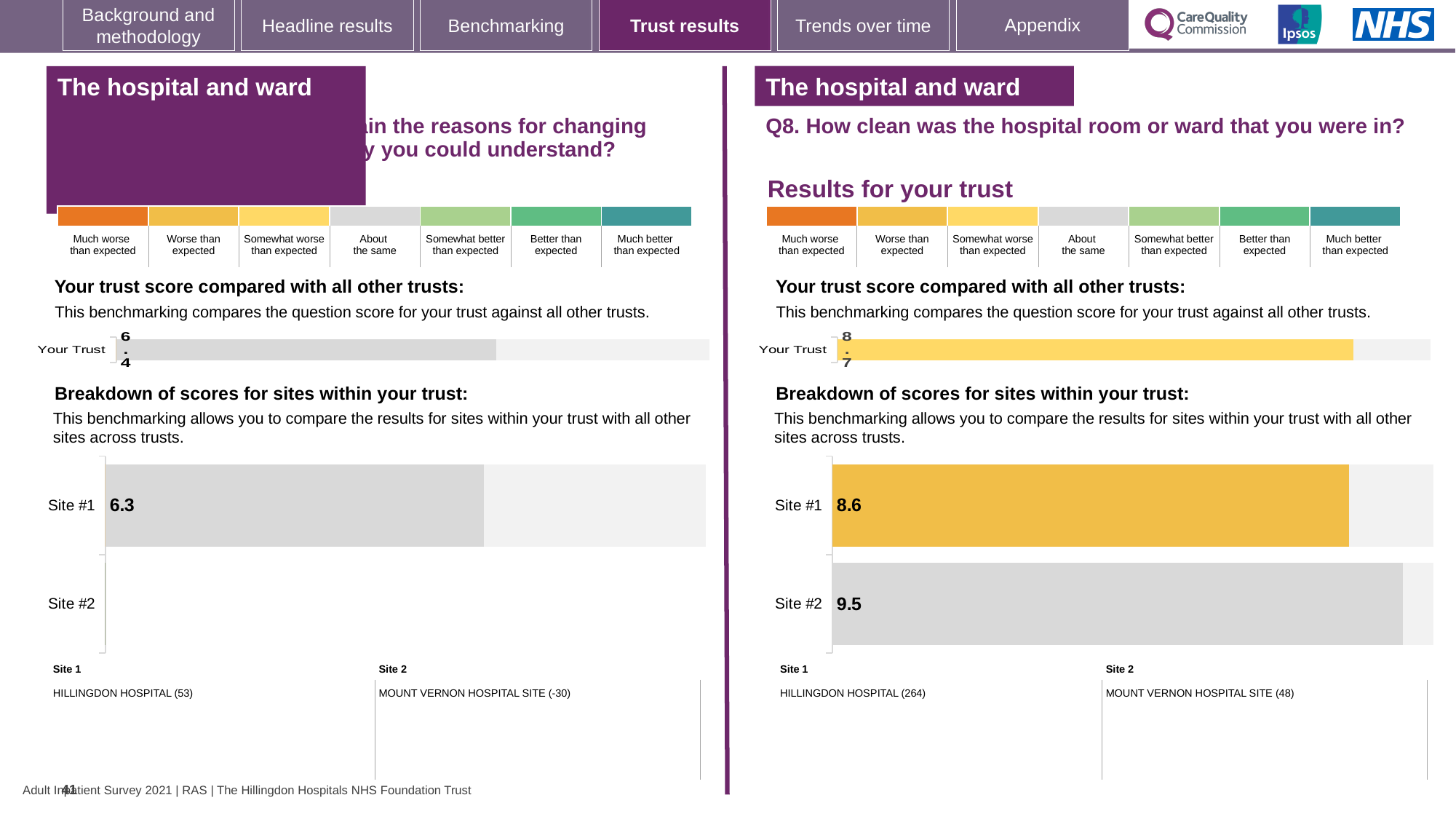
On the Q8 breakdown of scores for sites chart, what is the score for Site #2? 9.5 On the Q8 'How clean was the hospital room or ward' chart, what is the 'Your Trust' score? 8.7 How many sites are listed in the Q8 breakdown of scores for sites chart? 2 On the left-hand chart about explaining the reasons for changing wards, what is the 'Your Trust' score? 6.4 What is the difference between the 'Your Trust' score on the Q8 chart and the 'Your Trust' score on the left-hand chart? 2.3 On the Q8 breakdown of scores for sites chart, what is the score for Site #1? 8.6 On the Q8 breakdown of scores for sites chart, which site's bar is coloured yellow? Site #1 On the Q8 breakdown of scores for sites chart, what is the difference between the Site #2 and Site #1 scores? 0.9 On the Q8 breakdown of scores for sites chart, which site has the higher score? Site #2 Which is larger: the Site #1 score on the left-hand breakdown chart or the Site #1 score on the Q8 breakdown chart? Q8 Site #1 (8.6) On the left-hand breakdown of scores for sites chart, what is the score for Site #1? 6.3 What type of chart is used for the breakdown of scores for sites on the Q8 side? Bar chart